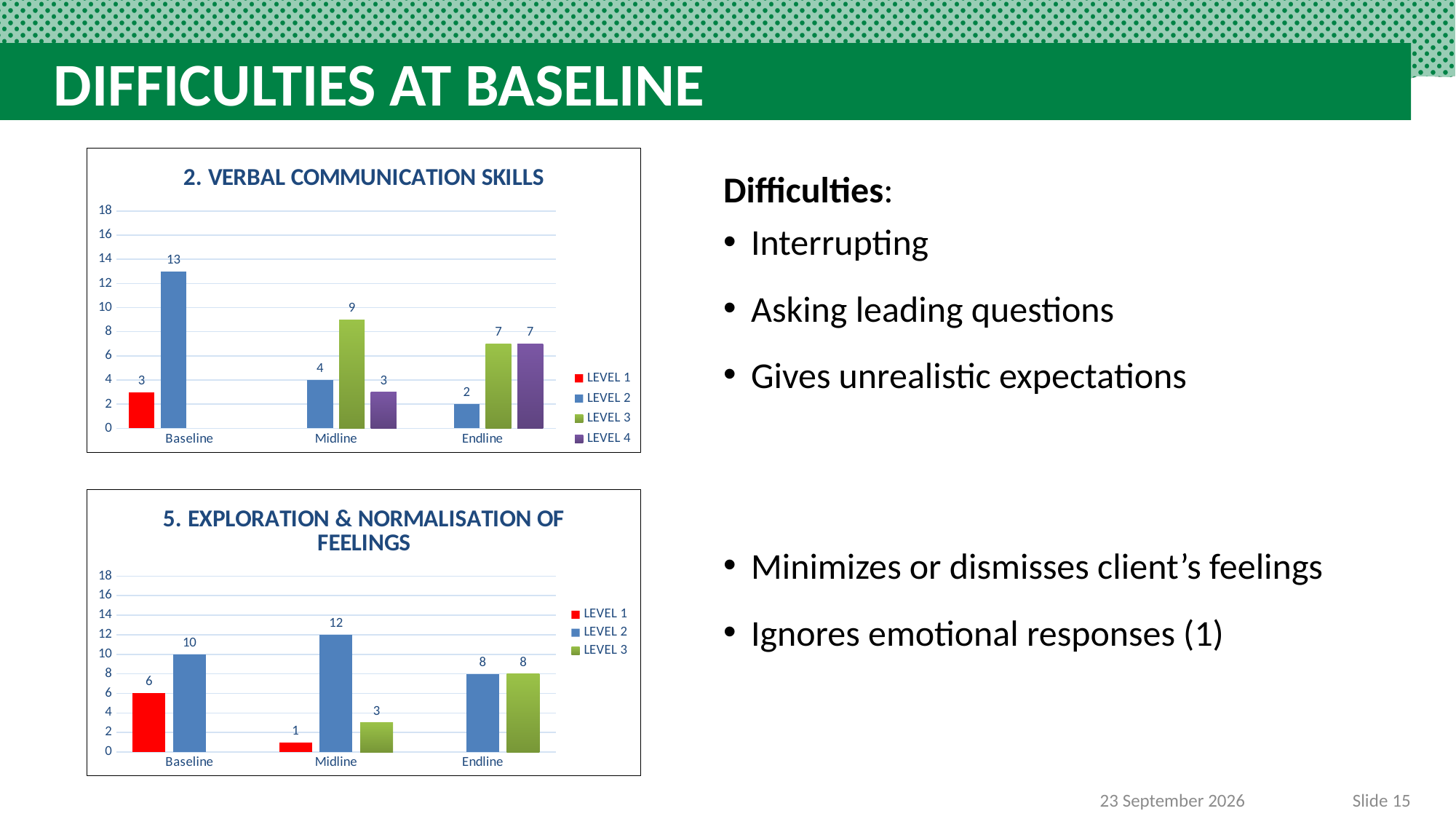
In the '2. VERBAL COMMUNICATION SKILLS' chart, how many series does the legend list? 4 What kind of chart is the '5. EXPLORATION & NORMALISATION OF FEELINGS' chart? bar chart In the '5. EXPLORATION & NORMALISATION OF FEELINGS' chart, how many categories are on the x axis? 3 In the '2. VERBAL COMMUNICATION SKILLS' chart, what is the value for LEVEL 2 at Baseline? 13 In the '2. VERBAL COMMUNICATION SKILLS' chart, what is the value for LEVEL 3 at Midline? 9 In the '5. EXPLORATION & NORMALISATION OF FEELINGS' chart, what is the value for LEVEL 2 at Midline? 12 In the '2. VERBAL COMMUNICATION SKILLS' chart, which series has the highest value at Baseline? LEVEL 2 In the '2. VERBAL COMMUNICATION SKILLS' chart, what is the difference between LEVEL 2 at Baseline and LEVEL 2 at Endline? 11 In the '2. VERBAL COMMUNICATION SKILLS' chart, does the LEVEL 2 value rise or fall from Baseline to Endline? fall In the '5. EXPLORATION & NORMALISATION OF FEELINGS' chart, which series has the lowest value at Midline? LEVEL 1 In the '5. EXPLORATION & NORMALISATION OF FEELINGS' chart, which is larger: LEVEL 2 at Baseline or LEVEL 2 at Endline? LEVEL 2 at Baseline In the '5. EXPLORATION & NORMALISATION OF FEELINGS' chart, what is the value for LEVEL 1 at Baseline? 6